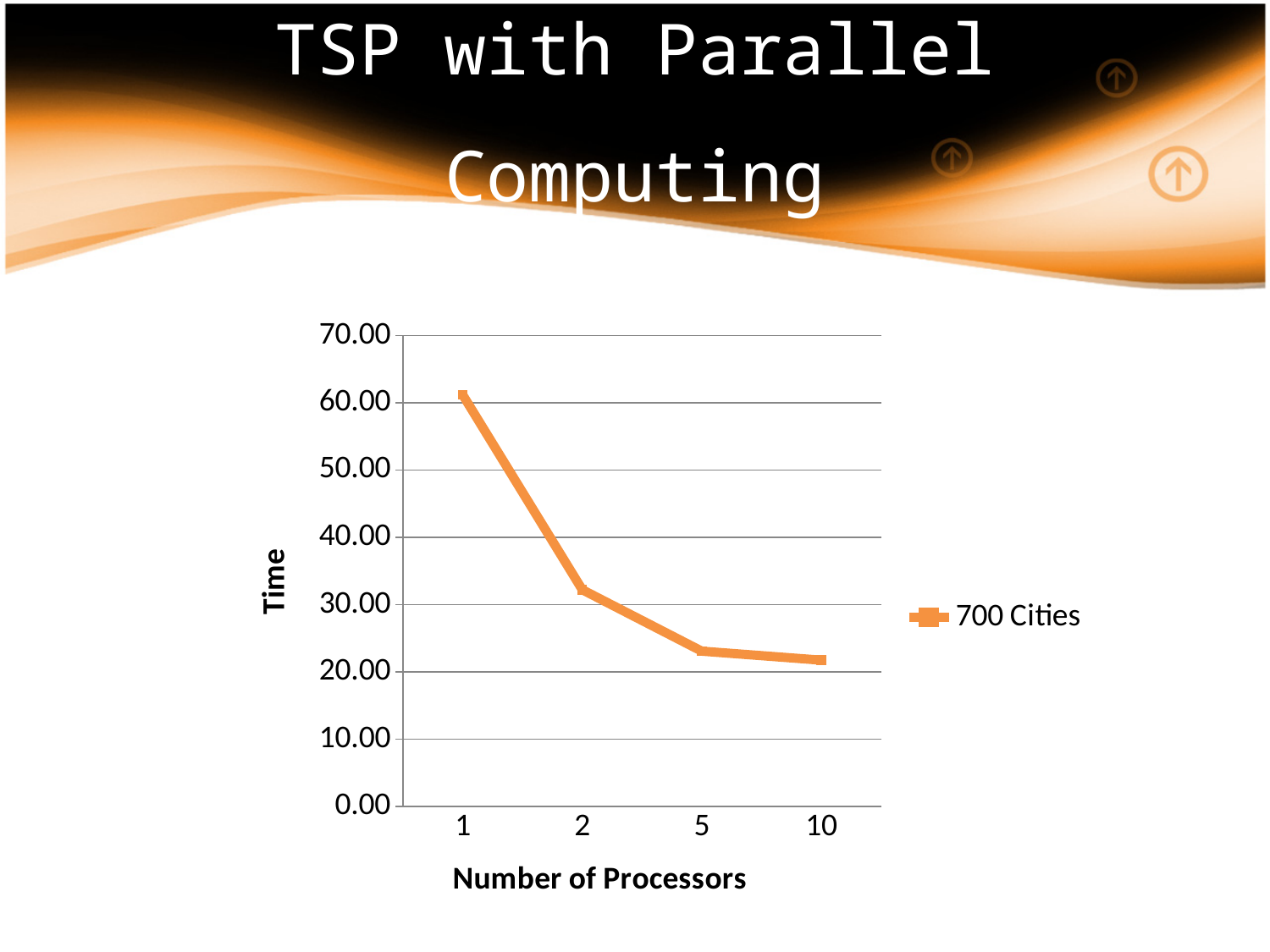
Is the time for 1 processor greater or less than 50.00? greater What kind of chart is shown on the slide? line chart What is the name of the series shown in the legend? 700 Cities Is the time for 5 processors greater or less than 30.00? less Which has the larger time, 1 processor or 2 processors? 1 processor Is the time for 2 processors greater or less than 40.00? less Do the values rise or fall as the number of processors increases? fall Which number of processors has the highest time? 1 How many data points are plotted along the x axis? 4 What is the label of the x axis? Number of Processors How many series does the legend list? 1